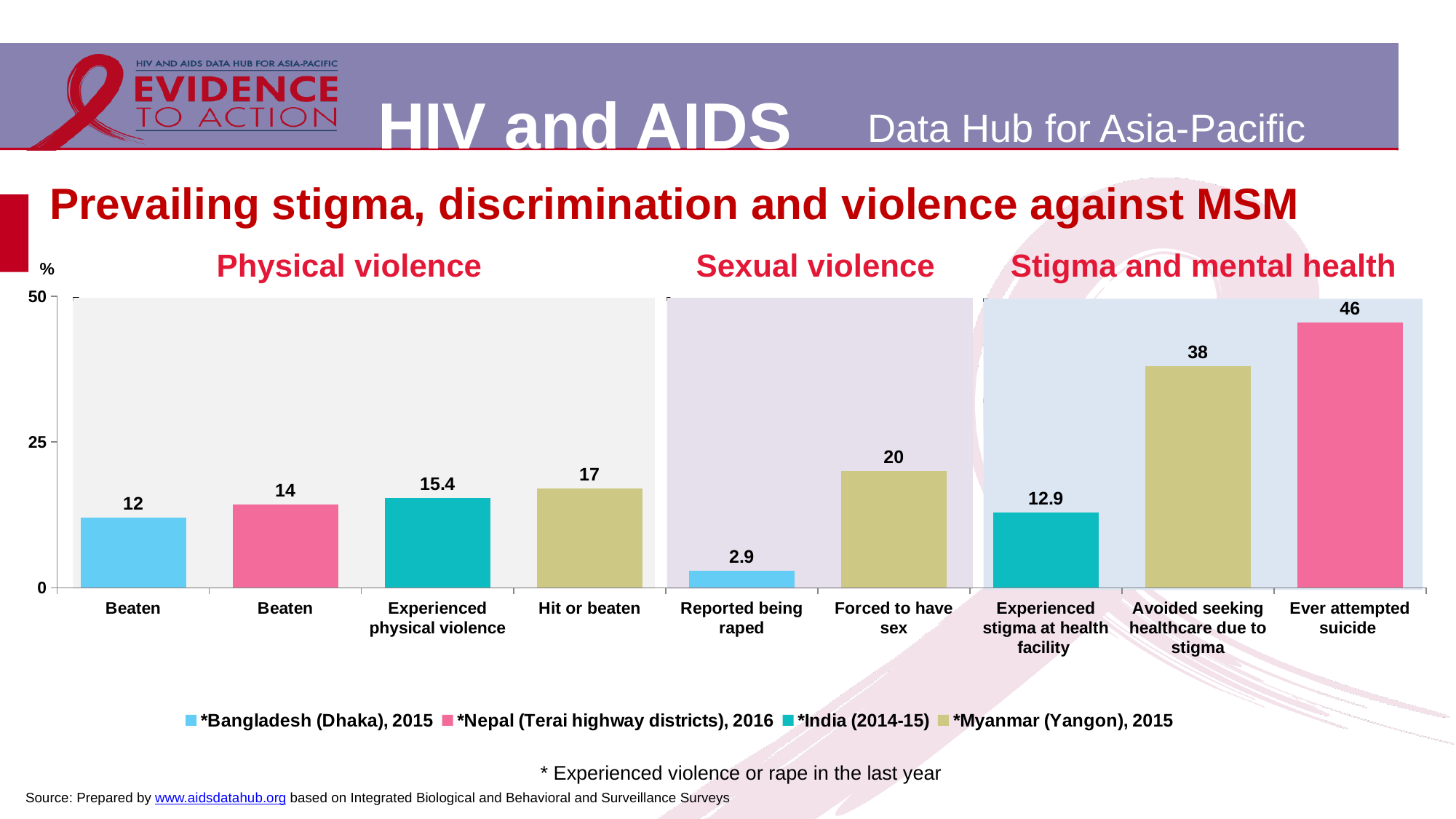
What kind of chart is shown on the slide? bar chart What is the value for "Avoided seeking healthcare due to stigma"? 38 How many series does the legend list? 4 Is the value for "Experienced stigma at health facility" greater or less than 25? less What is the value for "Experienced physical violence" in the Physical violence section? 15.4 Which category has the lowest value on the chart? Reported being raped How many bars are plotted on the chart? 9 What is the value for "Reported being raped" in the Sexual violence section? 2.9 What is the difference between "Ever attempted suicide" and "Avoided seeking healthcare due to stigma"? 8 Which category has the highest value on the chart? Ever attempted suicide What is the value for "Ever attempted suicide" in the Stigma and mental health section? 46 Which is larger: "Hit or beaten" or "Forced to have sex"? Forced to have sex